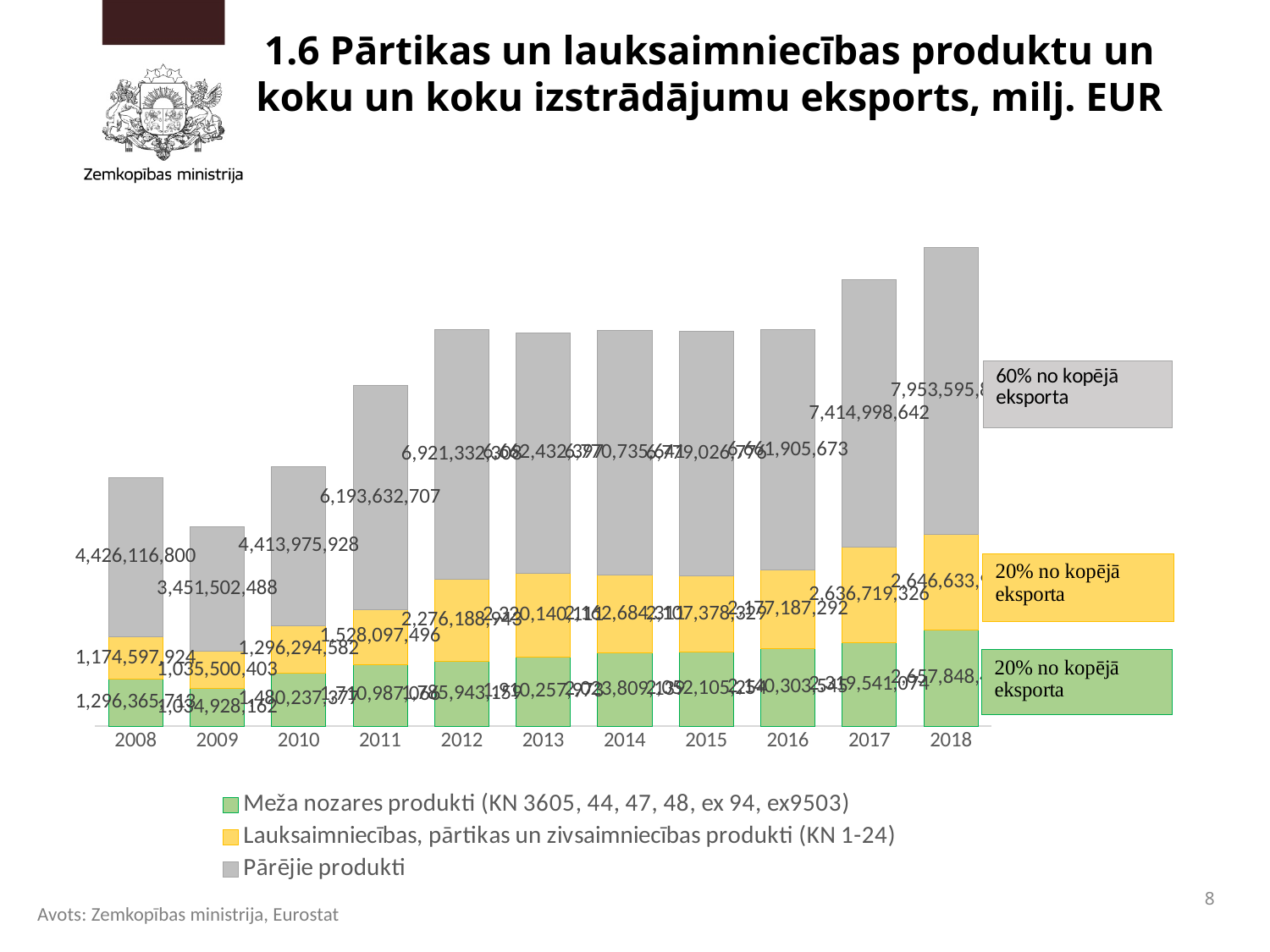
How many years are shown on the x axis of the chart? 11 What is the value of 'Lauksaimniecības, pārtikas un zivsaimniecības produkti (KN 1-24)' for 2011? 1,528,097,496 According to the annotation on the right, what share of total exports does 'Pārējie produkti' represent? 60% no kopējā eksporta What is the value of 'Pārējie produkti' for 2008? 4,426,116,800 What is the difference between the 'Pārējie produkti' values for 2008 and 2009? 974,614,312 Which year has the tallest total bar? 2018 What is the value of 'Lauksaimniecības, pārtikas un zivsaimniecības produkti (KN 1-24)' for 2016? 2,177,187,292 Which is larger, the 'Pārējie produkti' value for 2011 or for 2010? 2011 What kind of chart is shown on the slide? Stacked bar chart Which year has the shortest total bar? 2009 How many series does the chart legend list? 3 What is the value of 'Pārējie produkti' for 2017? 7,414,998,642